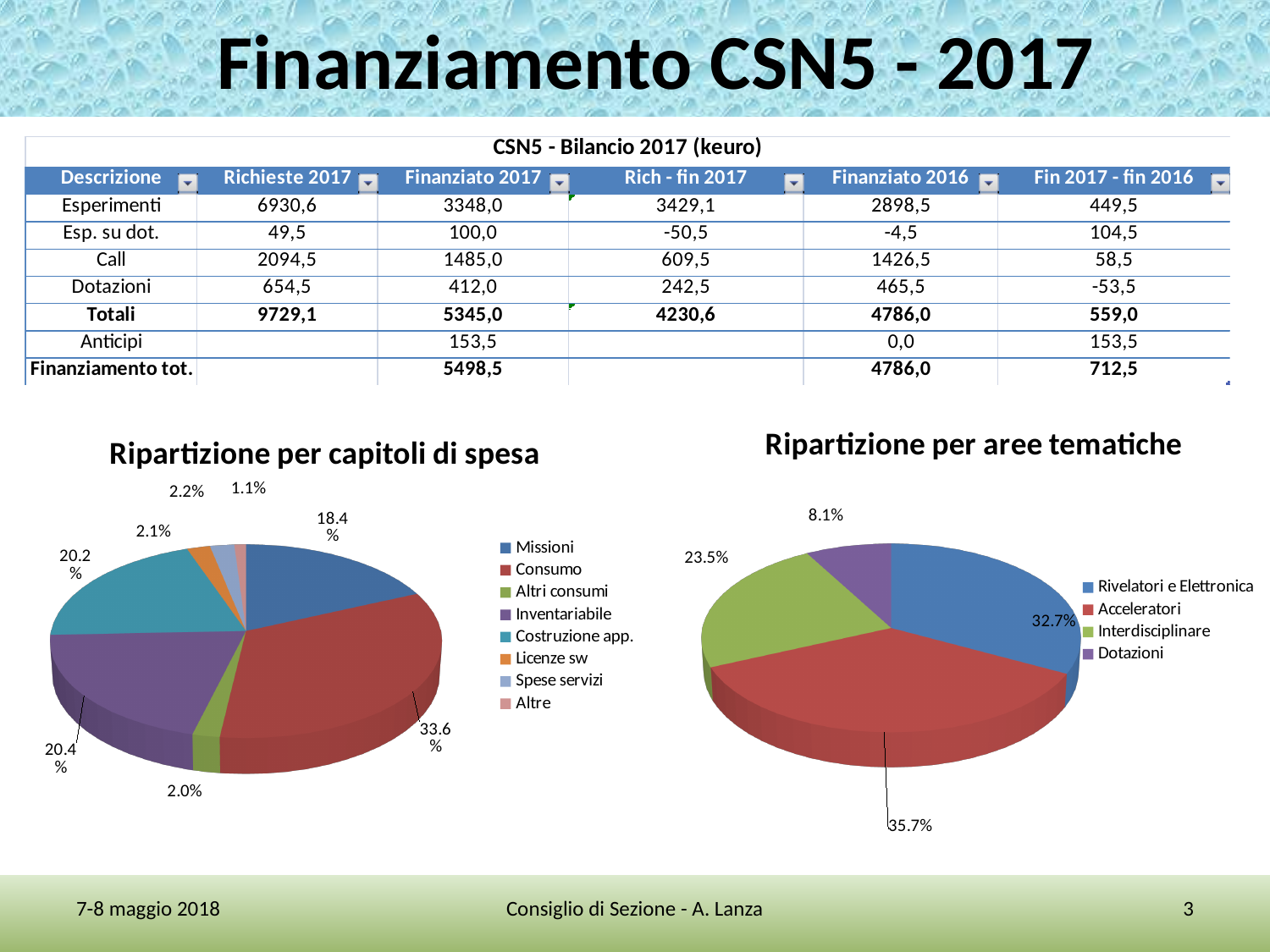
In the chart 'Ripartizione per capitoli di spesa', which category has the largest share? Consumo In the chart 'Ripartizione per aree tematiche', what share does Acceleratori have? 35.7% In the chart 'Ripartizione per capitoli di spesa', what share does Missioni have? 18.4% In the chart 'Ripartizione per aree tematiche', how many areas does the legend list? 4 In the chart 'Ripartizione per capitoli di spesa', what share does Consumo have? 33.6% In the chart 'Ripartizione per aree tematiche', what is the difference between the shares of Rivelatori e Elettronica and Interdisciplinare? 9.2% In the chart 'Ripartizione per aree tematiche', which area has the smallest share? Dotazioni In the chart 'Ripartizione per aree tematiche', what share does Dotazioni have? 8.1% In the chart 'Ripartizione per capitoli di spesa', which category has the smallest share? Altre In the chart 'Ripartizione per aree tematiche', which area has the largest share? Acceleratori In the chart 'Ripartizione per capitoli di spesa', how many categories does the legend list? 8 What type of chart is 'Ripartizione per capitoli di spesa'? Pie chart